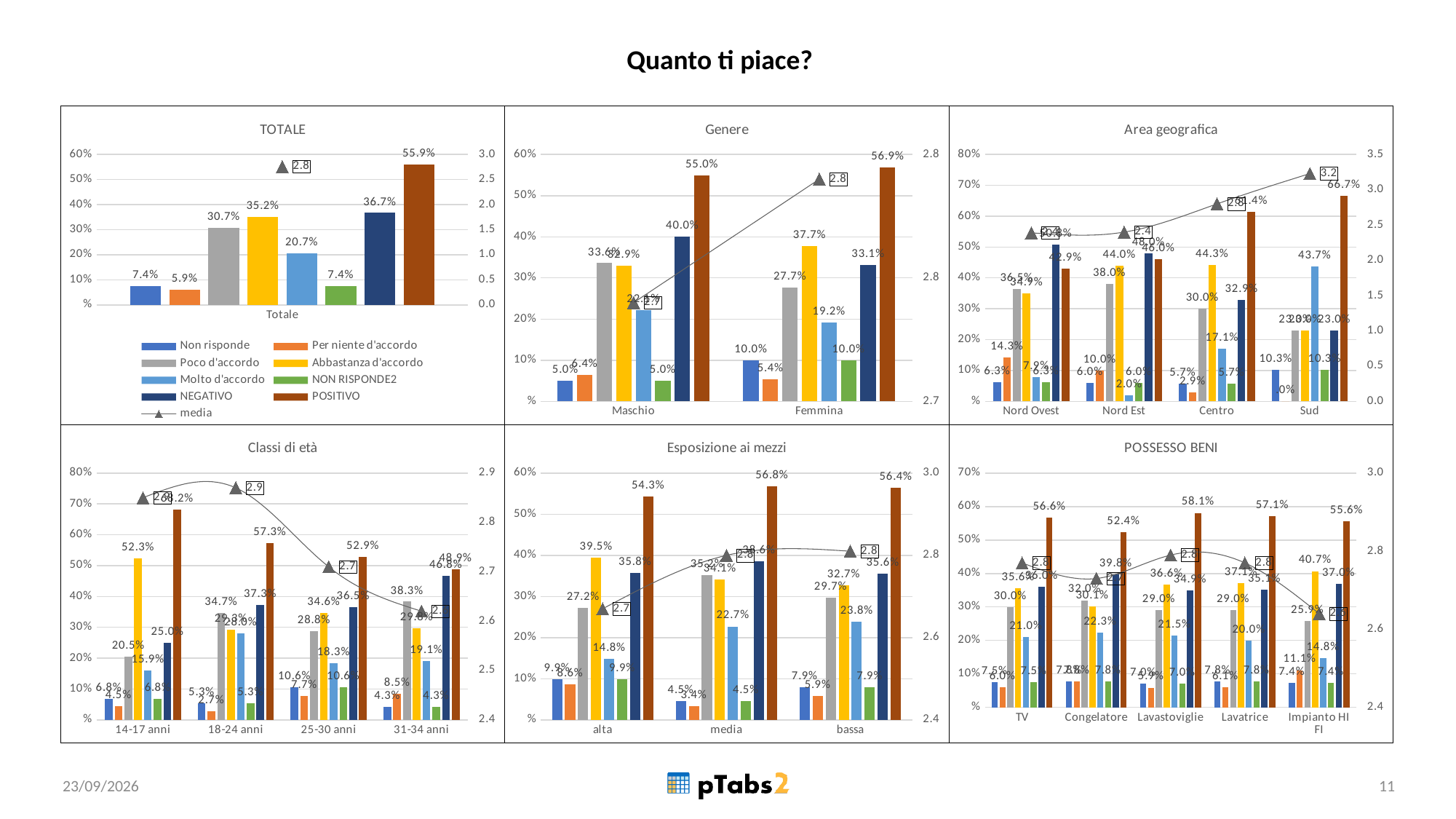
In the TOTALE chart, what is the value of the POSITIVO bar? 55.9% In the Genere chart, what is the POSITIVO value for Femmina? 56.9% In the Area geografica chart, what is the media value for Sud? 3.2 In the POSSESSO BENI chart, is the POSITIVO value for Congelatore larger or smaller than the POSITIVO value for TV? smaller In the Area geografica chart, which area has the highest POSITIVO value? Sud In the Esposizione ai mezzi chart, what is the POSITIVO value for alta? 54.3% In the POSSESSO BENI chart, which item has the highest POSITIVO value? Lavastoviglie In the Classi di età chart, which age class has the lowest POSITIVO value? 31-34 anni In the Classi di età chart, does the POSITIVO value rise or fall from 14-17 anni to 31-34 anni? fall How many categories are shown on the x axis of the Area geografica chart? 4 In the TOTALE chart, what is the value of the Abbastanza d'accordo bar? 35.2% In the Genere chart, what is the difference between the NEGATIVO values for Maschio and Femmina? 6.9%